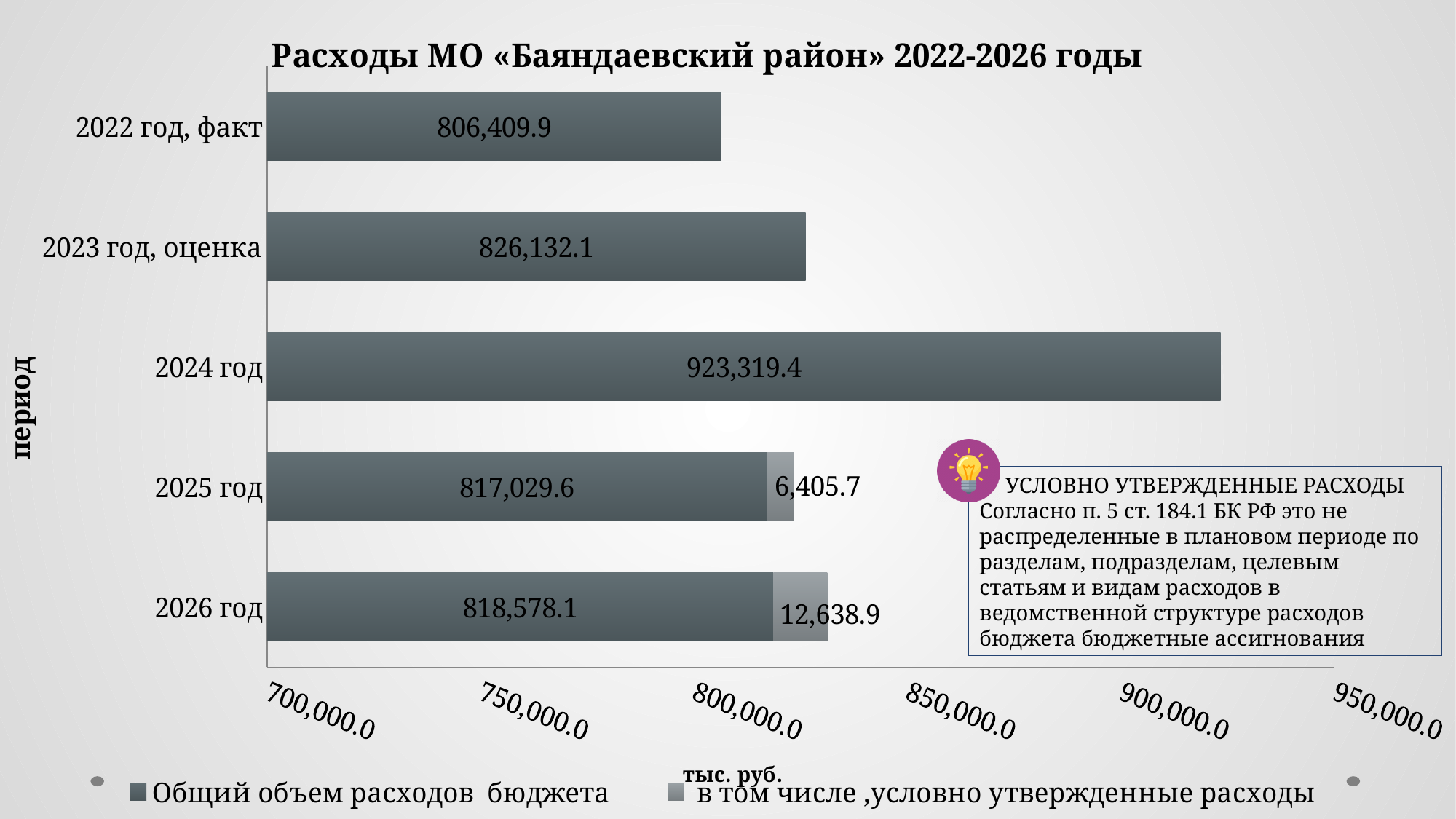
What is the value of 'Общий объем расходов бюджета' for 2022 год, факт? 806,409.9 What type of chart is shown on the slide? Bar chart How many series does the legend list? 2 Which is larger: 'в том числе, условно утвержденные расходы' for 2025 год or for 2026 год? 2026 год Which period has the lowest value of 'Общий объем расходов бюджета'? 2022 год, факт What is the value of 'в том числе, условно утвержденные расходы' for 2026 год? 12,638.9 What is the title of the chart? Расходы МО «Баяндаевский район» 2022-2026 годы What is the difference between 'Общий объем расходов бюджета' for 2024 год and 2022 год, факт? 116,909.5 How many periods (categories) are shown on the chart? 5 Which period has the highest value of 'Общий объем расходов бюджета'? 2024 год What is the value of 'Общий объем расходов бюджета' for 2024 год? 923,319.4 What is the total of the stacked bar for 2025 год? 823,435.3